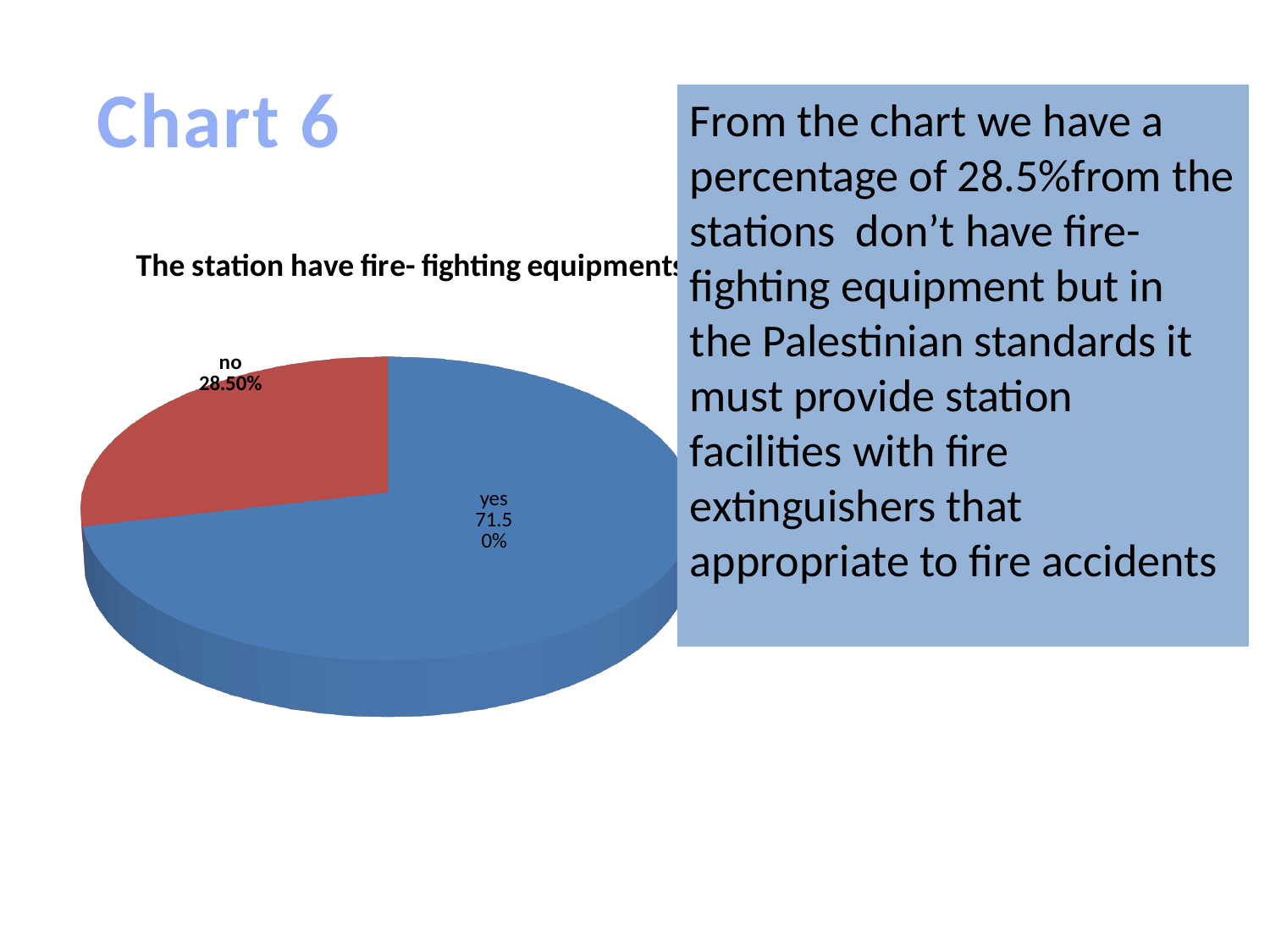
What kind of chart is shown on the slide? pie chart What is the title of the pie chart? The station have fire- fighting equipments Which slice of the pie is the smallest? no What percentage of the pie is labelled "yes"? 71.50% What percentage of the pie is labelled "no"? 28.50% What colour is the "no" slice of the pie? red What share of the pie does the "yes" slice represent? 71.50% What is the difference in percentage points between the "yes" slice and the "no" slice? 43 percentage points Which is larger, the "yes" slice or the "no" slice? yes How many slices does the pie chart have? 2 Which slice of the pie is the largest? yes